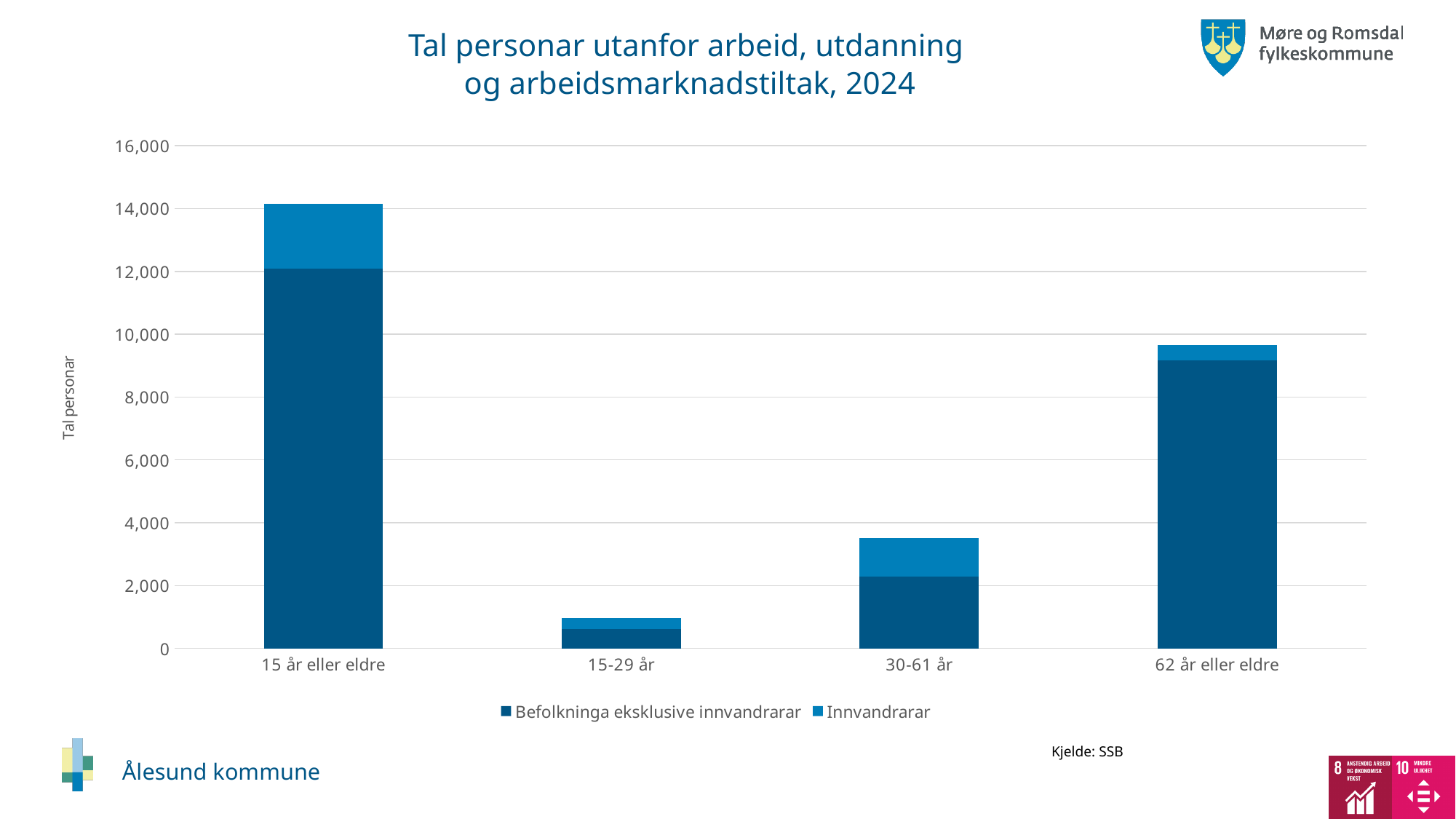
Which age group has the shortest total bar? 15-29 år What kind of chart is shown on the slide? Stacked bar chart Which has a larger total bar, 30-61 år or 62 år eller eldre? 62 år eller eldre Is the total value for 15 år eller eldre greater or less than 12,000? greater Is the total value for 62 år eller eldre greater or less than 10,000? less Which age group has the tallest total bar? 15 år eller eldre What is the title of the chart? Tal personar utanfor arbeid, utdanning og arbeidsmarknadstiltak, 2024 How many age-group categories are shown on the x axis? 4 How many series does the legend list? 2 Is the total value for 15-29 år greater or less than 2,000? less What are the two series named in the legend? Befolkninga eksklusive innvandrarar; Innvandrarar